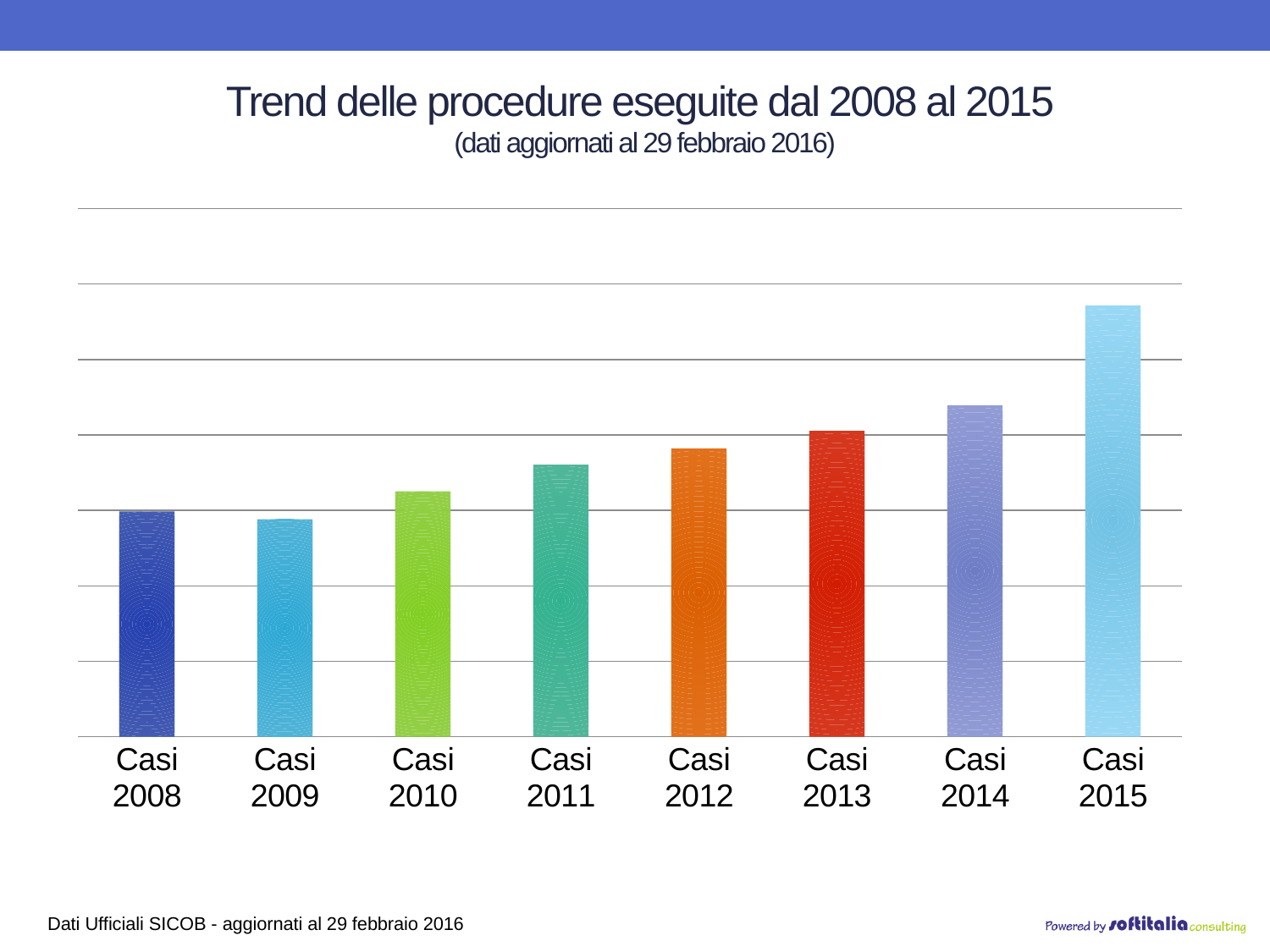
What is the title of the chart on the slide? Trend delle procedure eseguite dal 2008 al 2015 What kind of chart is shown on the slide? Bar chart Do the values generally rise or fall from Casi 2009 to Casi 2015? Rise What is the label of the first category on the x axis? Casi 2008 How many bars (categories) are shown in the chart? 8 Which is larger, the value for Casi 2010 or the value for Casi 2012? Casi 2012 Which is larger, the value for Casi 2014 or the value for Casi 2013? Casi 2014 Which is larger, the value for Casi 2008 or the value for Casi 2013? Casi 2013 Which category has the highest bar in the chart? Casi 2015